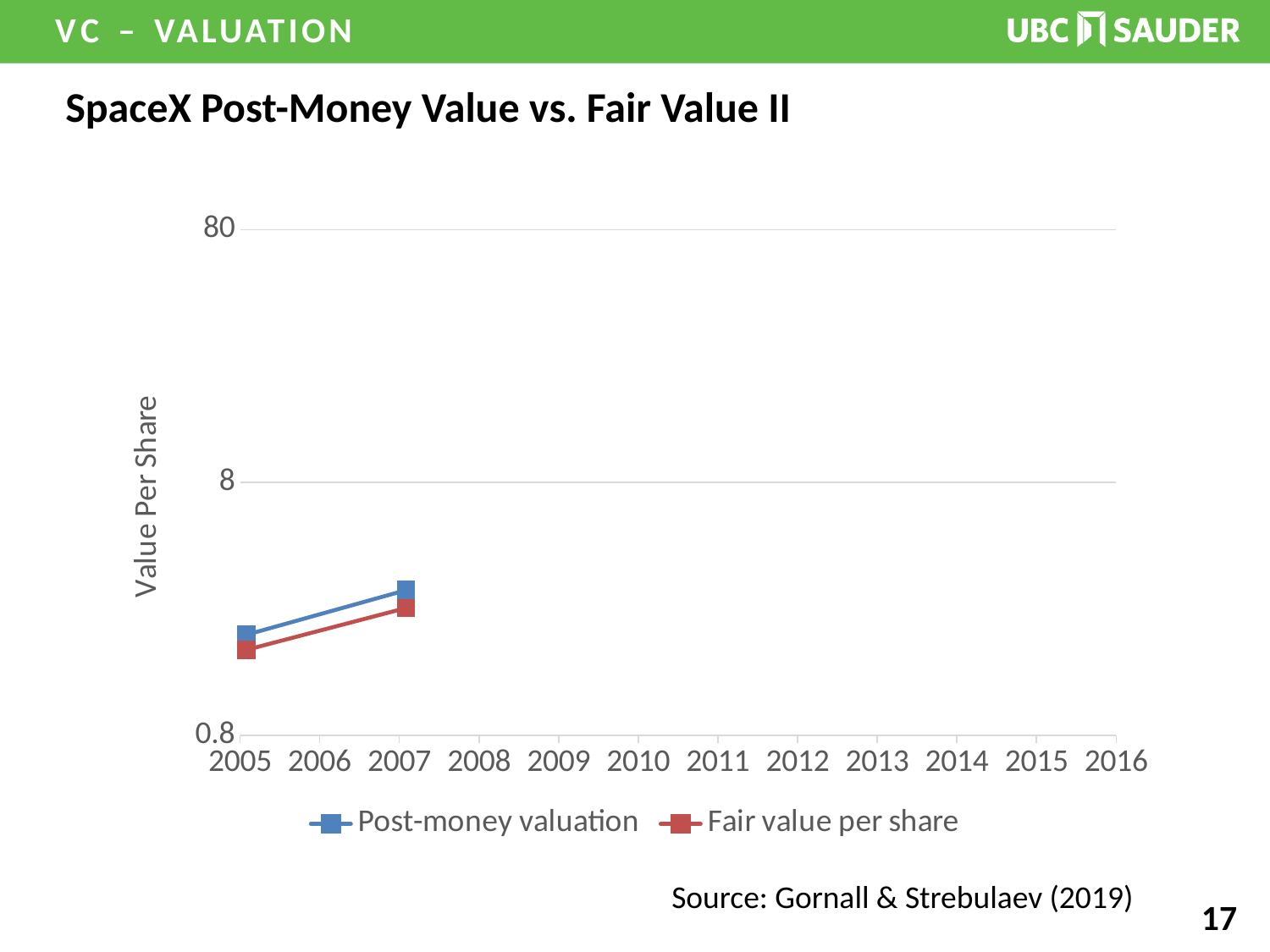
How many series does the legend list? 2 How many data points are plotted for the Post-money valuation series? 2 Does the Post-money valuation rise or fall from 2005 to 2007? Rise In 2005, which is larger: the Post-money valuation or the Fair value per share? Post-money valuation Is the Post-money valuation in 2007 greater or less than 8? less What is the title of the chart? SpaceX Post-Money Value vs. Fair Value II In 2007, which is larger: the Post-money valuation or the Fair value per share? Post-money valuation Is the Fair value per share in 2005 greater or less than 0.8? greater Does the Fair value per share rise or fall from 2005 to 2007? Rise Which year has the higher Fair value per share, 2005 or 2007? 2007 What kind of chart is shown on the slide? Line chart What are the two series named in the legend? Post-money valuation; Fair value per share